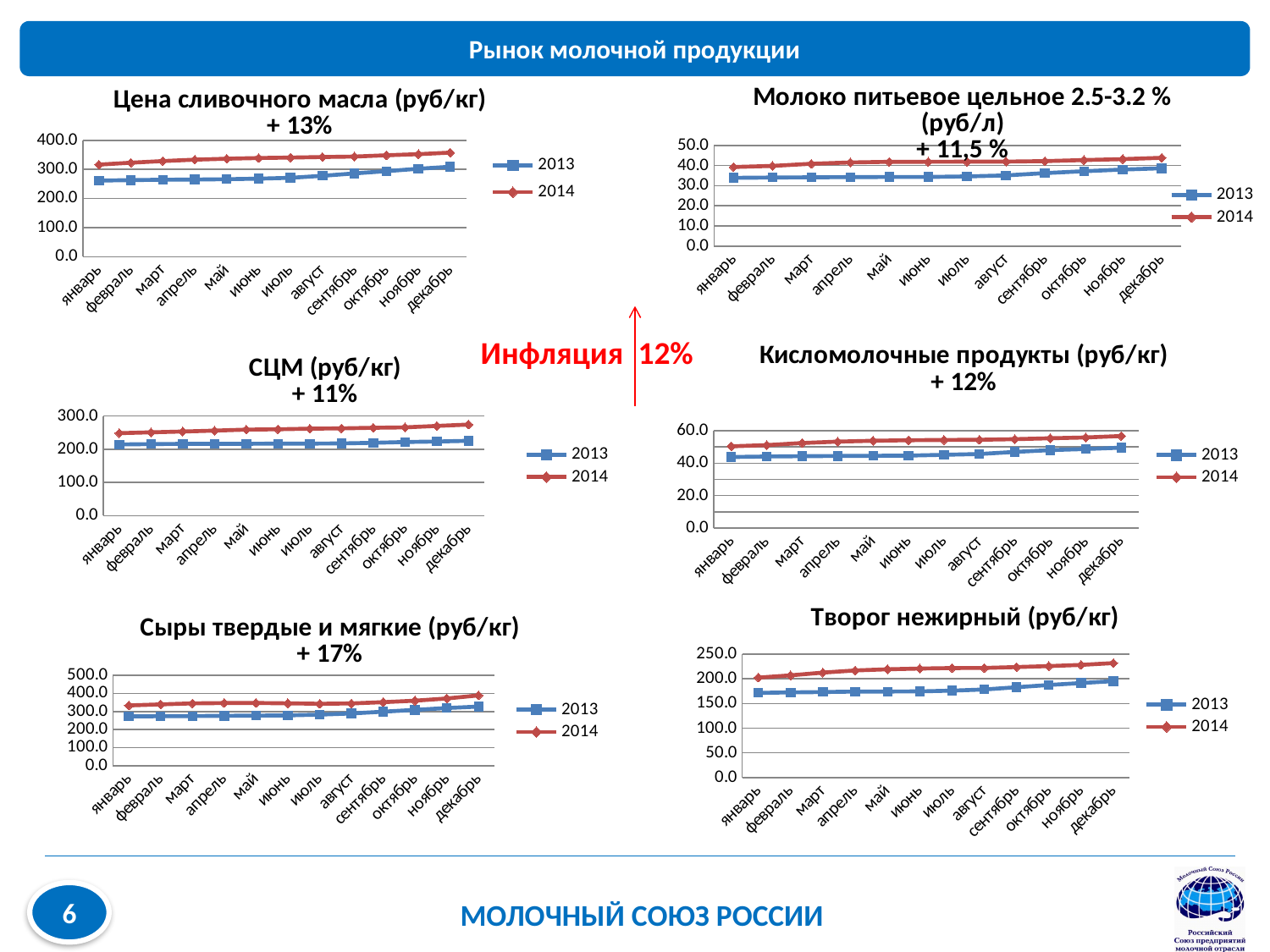
In the "Сыры твердые и мягкие (руб/кг)" chart, is the 2013 value for январь greater or less than 300? less In the "Цена сливочного масла (руб/кг)" chart, is the 2014 value for декабрь greater or less than 300? greater How many series does the legend of the "Цена сливочного масла (руб/кг)" chart list? 2 How many months are shown on the x axis of the "Творог нежирный (руб/кг)" chart? 12 In the "Творог нежирный (руб/кг)" chart, does the 2013 line rise or fall from январь to декабрь? rise What percentage change is printed under the title of the "Сыры твердые и мягкие (руб/кг)" chart? + 17% In the "Кисломолочные продукты (руб/кг)" chart, is the 2014 value for декабрь greater or less than 40? greater In the "Цена сливочного масла (руб/кг)" chart, which series is higher in январь, 2013 or 2014? 2014 In the "Цена сливочного масла (руб/кг)" chart, does the 2014 line rise or fall from январь to декабрь? rise What kind of chart is the "Цена сливочного масла (руб/кг)" chart? line chart